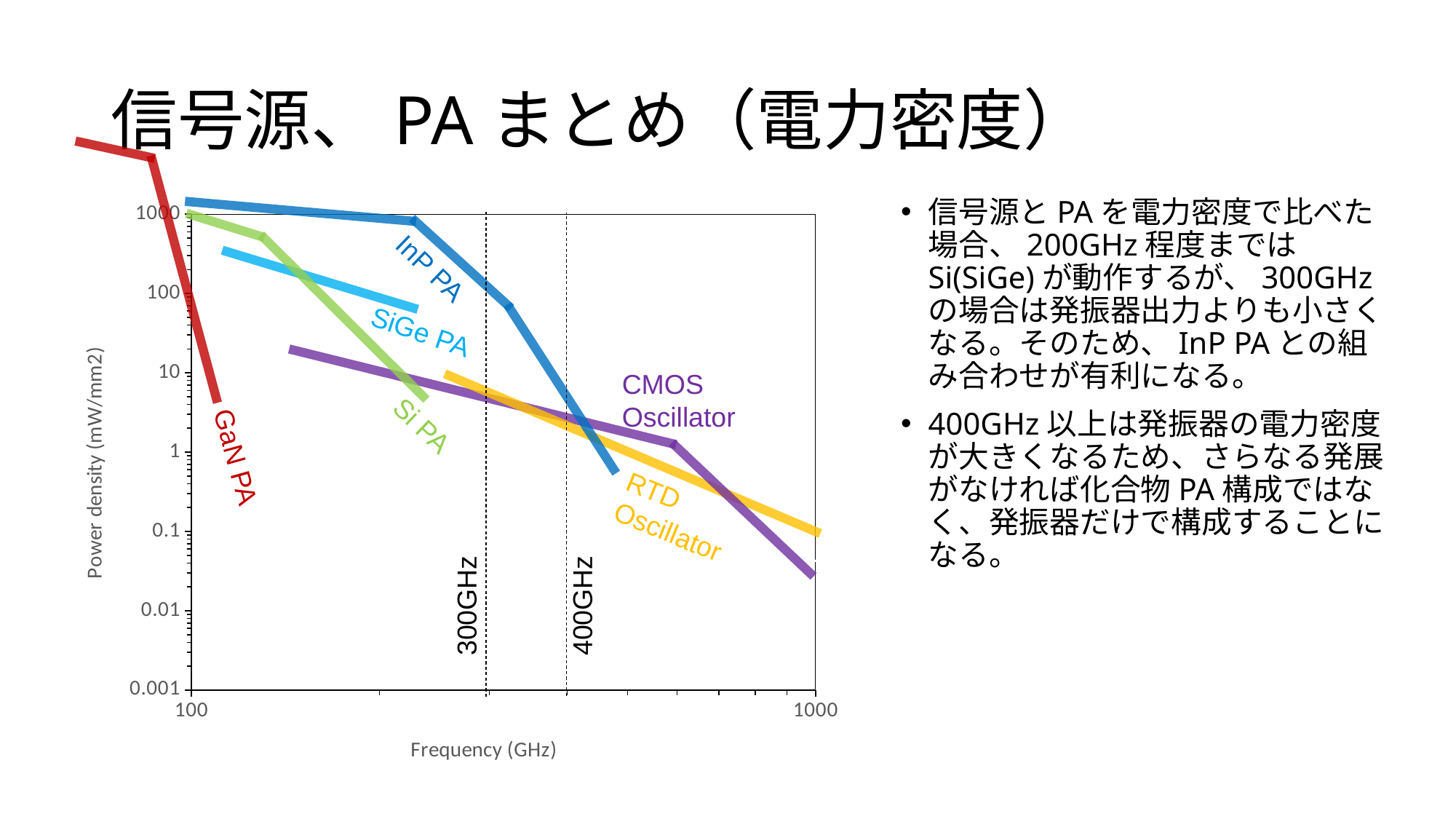
Which PA line extends to the highest frequency on the chart? InP PA What is the label of the y axis of the chart? Power density (mW/mm2) Do the plotted power density values rise or fall as frequency increases? fall Is the value for InP PA at 400GHz greater or less than 1? greater Is the value for RTD Oscillator at 400GHz greater or less than 1? greater How many labeled lines (series) are plotted on the chart? 6 At 300GHz, which is higher: InP PA or CMOS Oscillator? InP PA Is the value for CMOS Oscillator at 1000 GHz greater or less than 0.1? less What is the label of the x axis of the chart? Frequency (GHz) At 1000 GHz, which is higher: RTD Oscillator or CMOS Oscillator? RTD Oscillator What kind of chart is shown on the slide? line chart